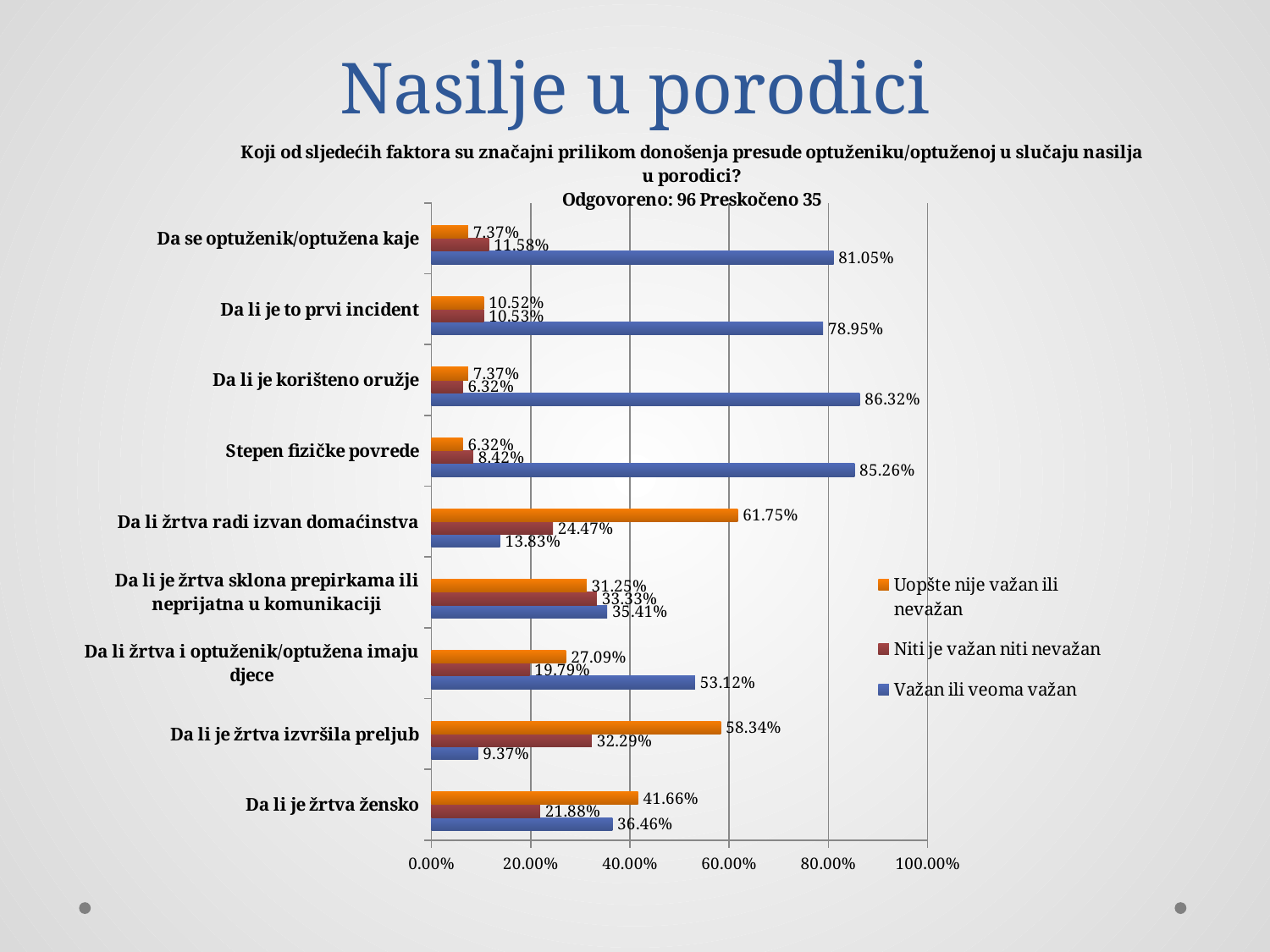
What is the value of "Niti je važan niti nevažan" for "Da li je žrtva izvršila preljub"? 32.29% What is the difference between "Važan ili veoma važan" and "Niti je važan niti nevažan" for "Da se optuženik/optužena kaje"? 69.47% Which category has the highest value for "Važan ili veoma važan"? Da li je korišteno oružje How many series does the legend list? 3 How many categories (factors) are shown on the chart? 9 Which category has the lowest value for "Važan ili veoma važan"? Da li je žrtva izvršila preljub Is the value of "Važan ili veoma važan" for "Da li žrtva i optuženik/optužena imaju djece" greater or less than 40.00%? greater What is the value of "Važan ili veoma važan" for "Da li je korišteno oružje"? 86.32% Which colour represents the series "Važan ili veoma važan"? Blue For "Da li je žrtva žensko", which is larger: "Uopšte nije važan ili nevažan" or "Važan ili veoma važan"? Uopšte nije važan ili nevažan What is the value of "Uopšte nije važan ili nevažan" for "Da li žrtva radi izvan domaćinstva"? 61.75% What kind of chart is shown on the slide? Bar chart